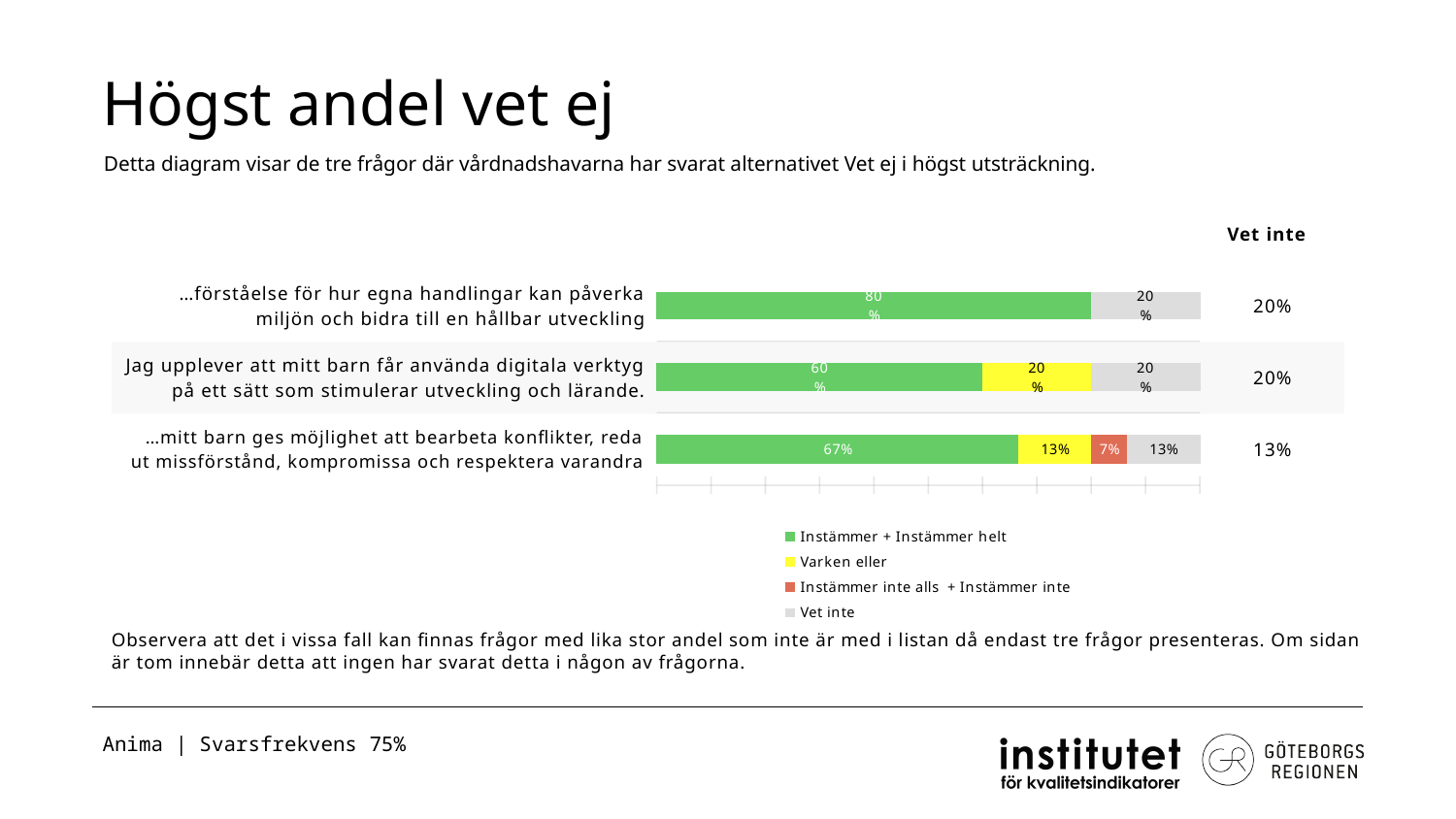
What is the 'Vet inte' value for '…mitt barn ges möjlighet att bearbeta konflikter, reda ut missförstånd, kompromissa och respektera varandra'? 13% How many series does the legend list? 4 Which is larger: the 'Instämmer + Instämmer helt' value for the second question or for the third question? the third question (67%) Which question has the highest 'Instämmer + Instämmer helt' share? …förståelse för hur egna handlingar kan påverka miljön och bidra till en hållbar utveckling What is the difference between the 'Instämmer + Instämmer helt' values for the first question (80%) and the second question (60%)? 20% Which question has the lowest 'Vet inte' share? …mitt barn ges möjlighet att bearbeta konflikter, reda ut missförstånd, kompromissa och respektera varandra What is the 'Varken eller' value for 'Jag upplever att mitt barn får använda digitala verktyg på ett sätt som stimulerar utveckling och lärande.'? 20% How many questions (categories) are plotted in the chart? 3 What kind of chart is shown on the slide? stacked bar chart Which legend entry is shown in grey? Vet inte What is the 'Instämmer + Instämmer helt' value for '…förståelse för hur egna handlingar kan påverka miljön och bidra till en hållbar utveckling'? 80% What is the 'Instämmer inte alls + Instämmer inte' value for '…mitt barn ges möjlighet att bearbeta konflikter, reda ut missförstånd, kompromissa och respektera varandra'? 7%